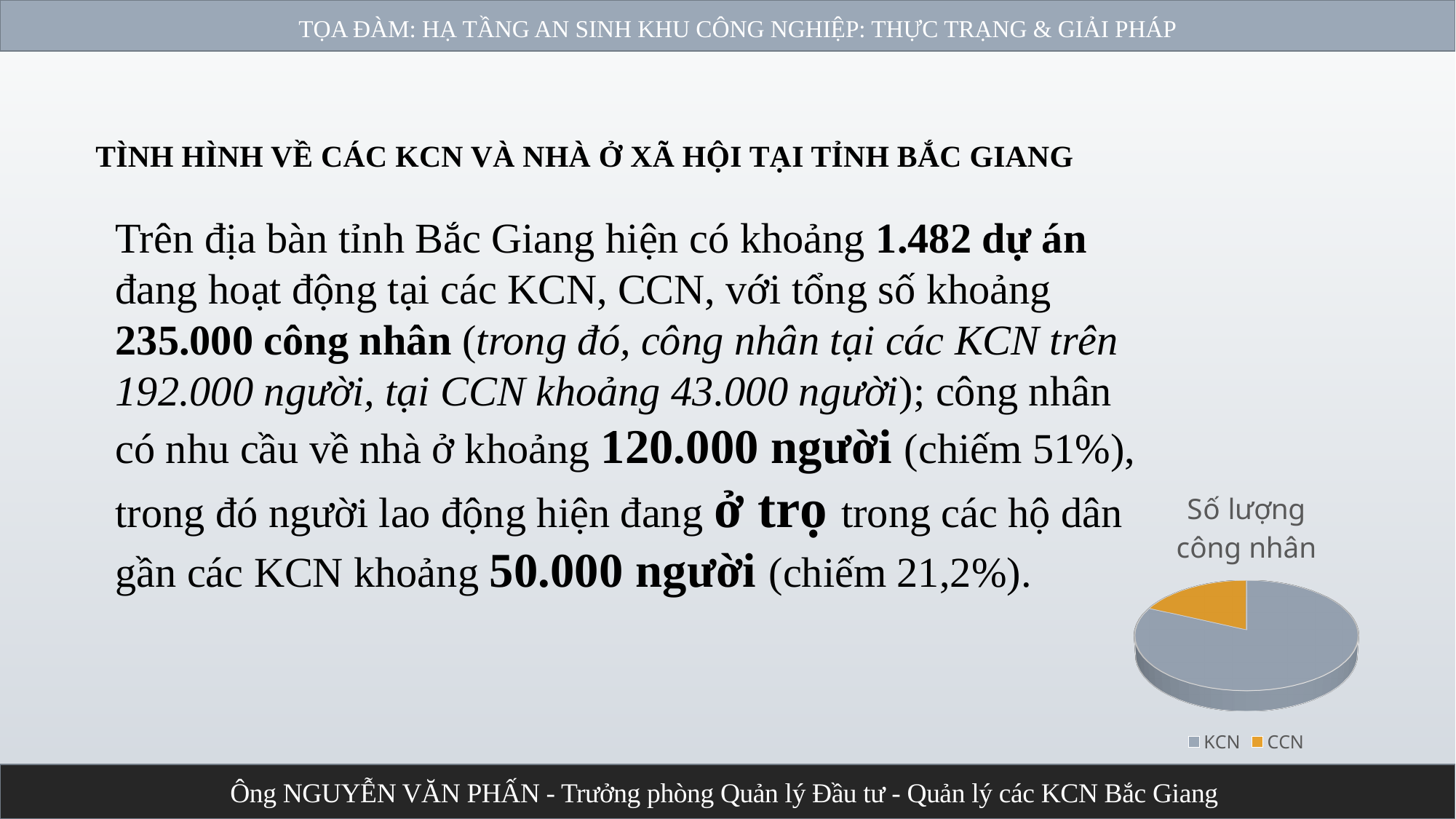
In the pie chart, which slice is larger, KCN or CCN? KCN Is the KCN slice more or less than half of the pie chart? more What kind of chart is shown on the slide? pie chart How many entries does the legend of the pie chart list? 2 What is the title of the pie chart? Số lượng công nhân Which category has the largest slice in the pie chart? KCN Which category has the smallest slice in the pie chart? CCN How many slices does the pie chart have? 2 What colour is the CCN slice in the pie chart? orange